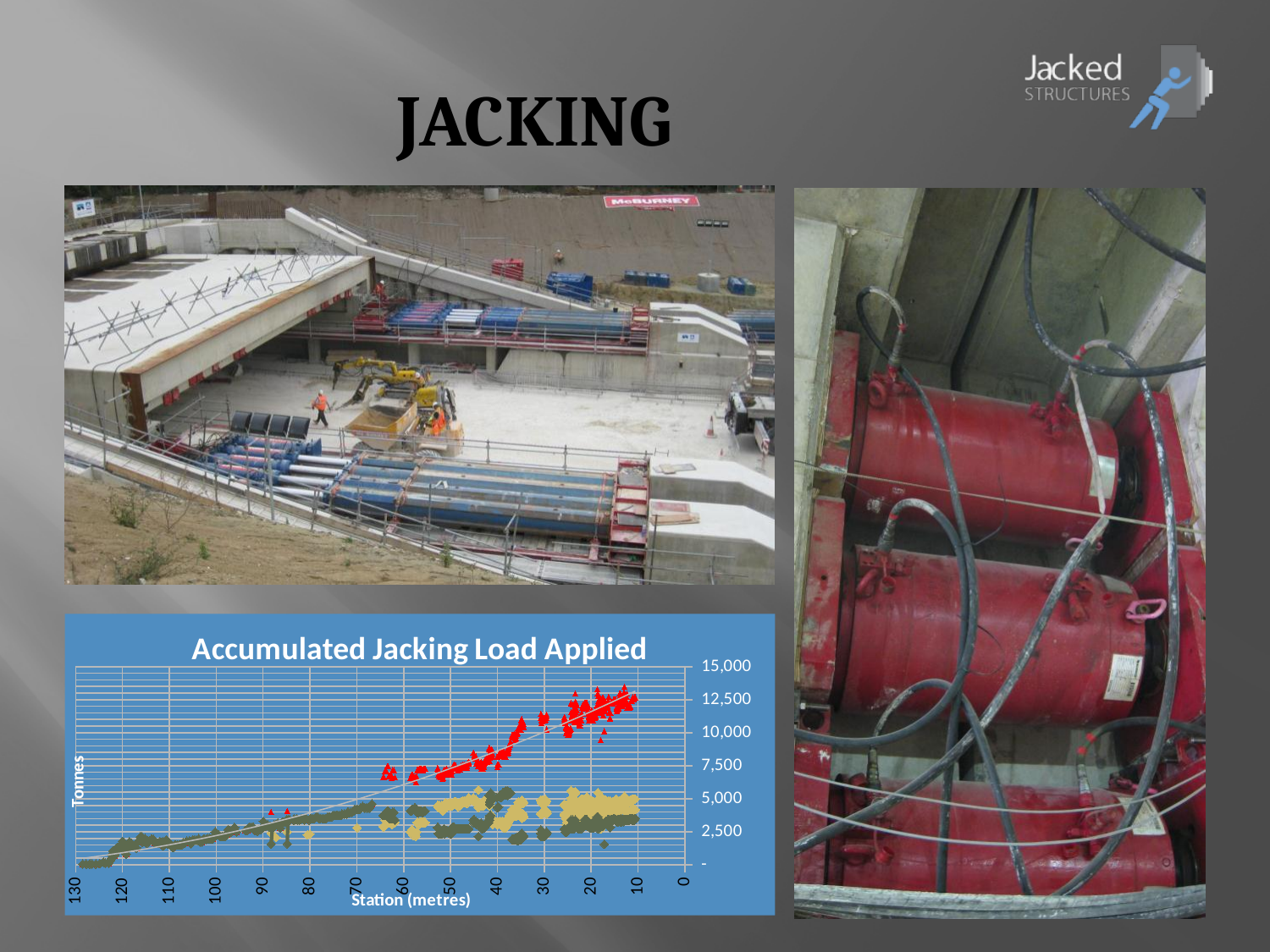
What is the title of the chart on the slide? Accumulated Jacking Load Applied What is the label of the horizontal axis on the Accumulated Jacking Load Applied chart? Station (metres) On the Accumulated Jacking Load Applied chart, which series has higher values at station 30: the red triangles or the olive diamonds? red triangles On the Accumulated Jacking Load Applied chart, is the value of the olive diamond series at station 120 greater or less than 2,500? less On the Accumulated Jacking Load Applied chart, do the plotted values rise or fall moving from left to right along the x axis? rise What kind of chart is the Accumulated Jacking Load Applied chart? scatter chart What is the label of the vertical axis on the Accumulated Jacking Load Applied chart? Tonnes On the Accumulated Jacking Load Applied chart, is the value of the olive diamond series at station 20 greater or less than 7,500? less On the Accumulated Jacking Load Applied chart, is the value of the red triangle series at station 60 greater or less than 5,000? greater